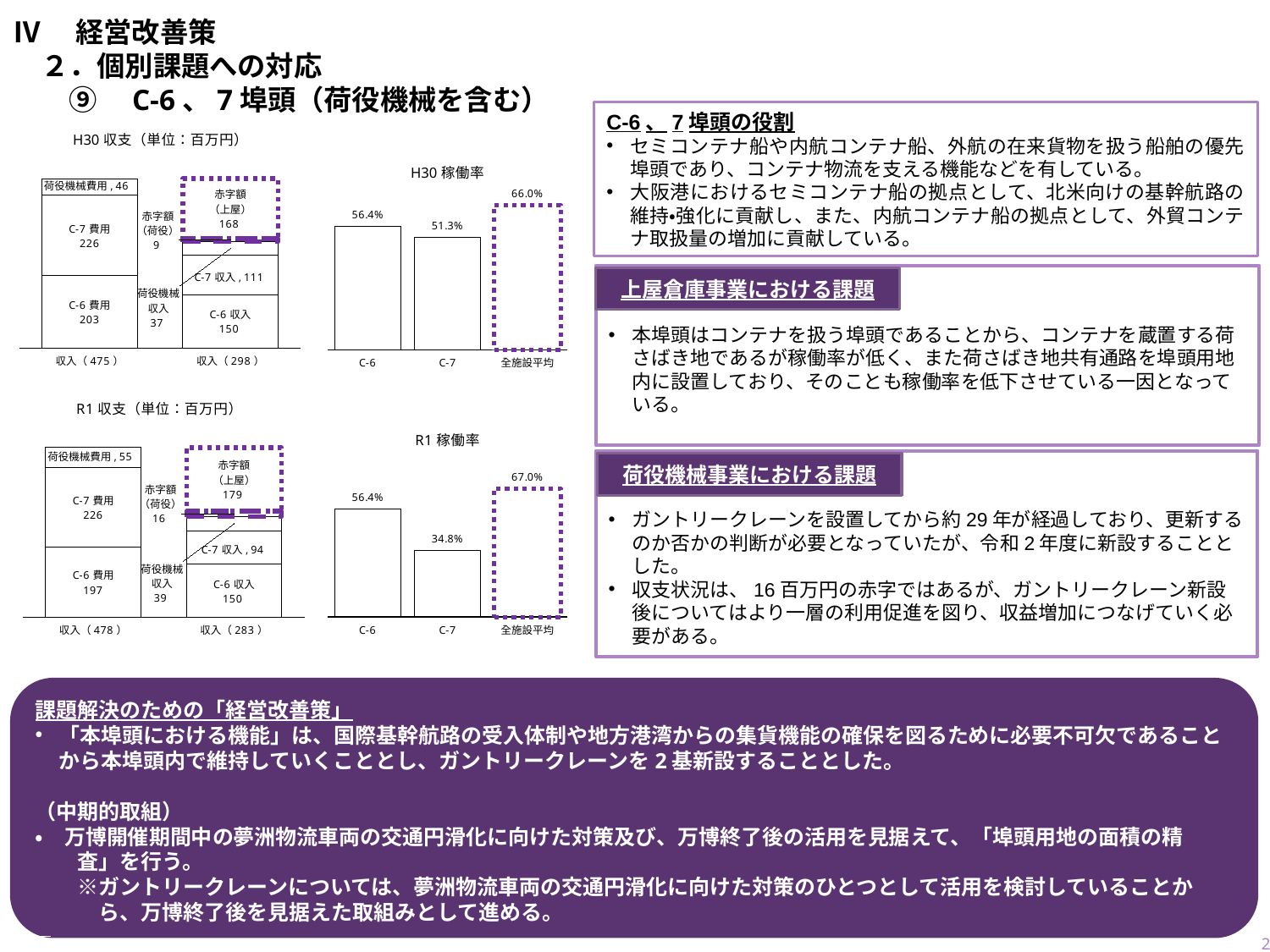
What kind of chart is the H30 稼働率 chart? Bar chart In the R1 稼働率 chart, which category has the lowest value? C-7 In the R1 稼働率 chart, what is the value for 全施設平均? 67.0% In the R1 稼働率 chart, which is larger, C-6 or C-7? C-6 In the H30 収支 chart, what is the value of C-6 費用? 203 In the R1 収支 chart, what is the value of 赤字額（上屋）? 179 In the H30 収支 chart, what is the value of C-7 収入? 111 In the H30 稼働率 chart, which category has the highest value? 全施設平均 In the H30 稼働率 chart, what is the value for C-7? 51.3% In the R1 収支 chart, what is the value of 荷役機械費用? 55 In the R1 収支 chart, what is the total of the cost bar (C-6 費用, C-7 費用 and 荷役機械費用)? 478 In the H30 稼働率 chart, what is the difference between 全施設平均 and C-6? 9.6 percentage points